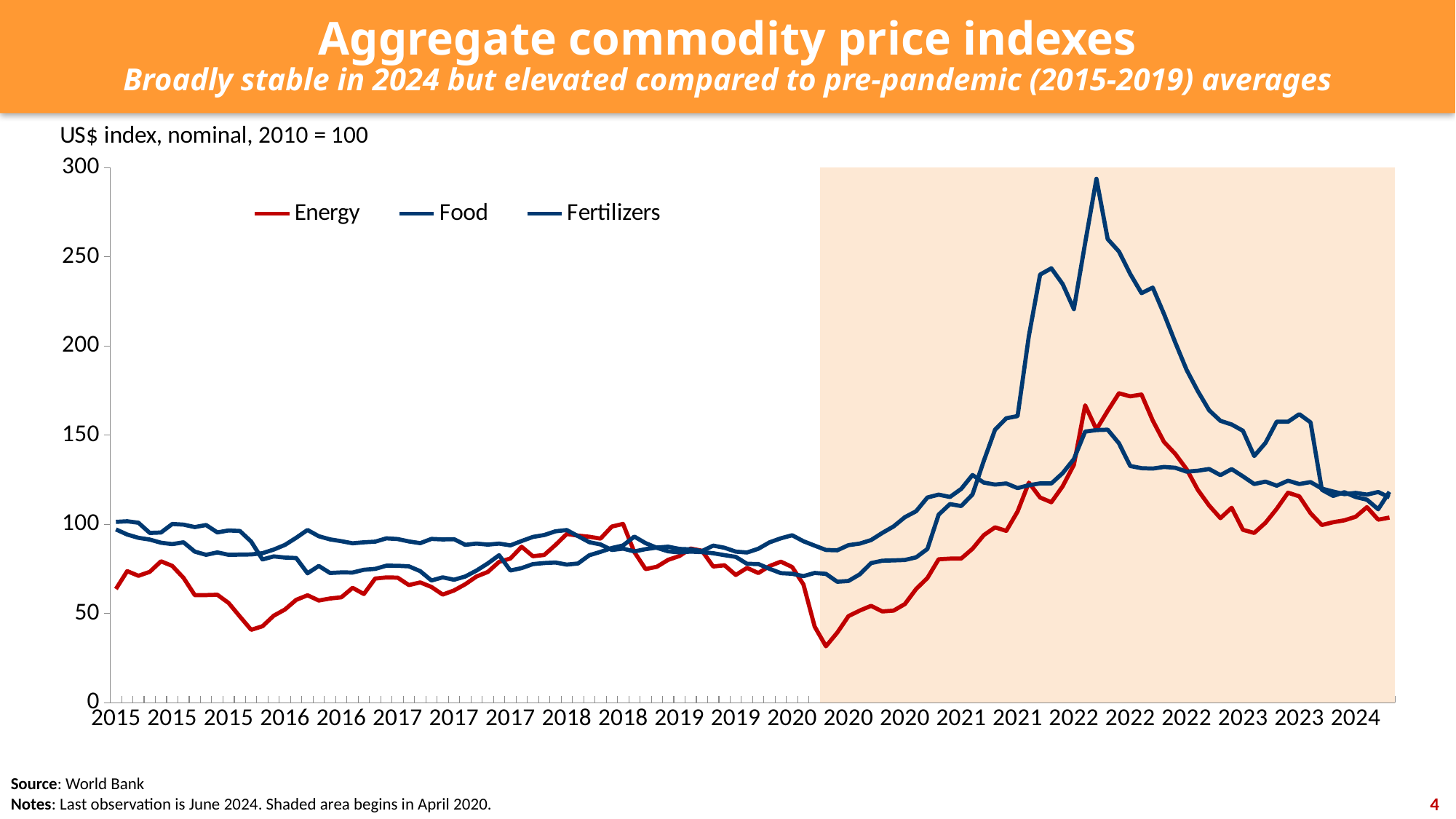
What kind of chart is shown on the slide? Line chart Is the Energy index at the start of 2015 greater or less than 100? less Is the Energy index at the last observation in 2024 greater or less than 150? less What is the title of the chart? Aggregate commodity price indexes Does the Energy index rise or fall from its 2022 peak to the end of 2023? fall How many series does the legend list? 3 Is the lowest value of the Energy index in 2020 greater or less than 50? less Does the Energy index rise or fall between its 2020 low and its 2022 peak? rise Which is higher: the Energy index at the start of 2015 or the Energy index at its 2022 peak? 2022 peak Which series is drawn in red? Energy